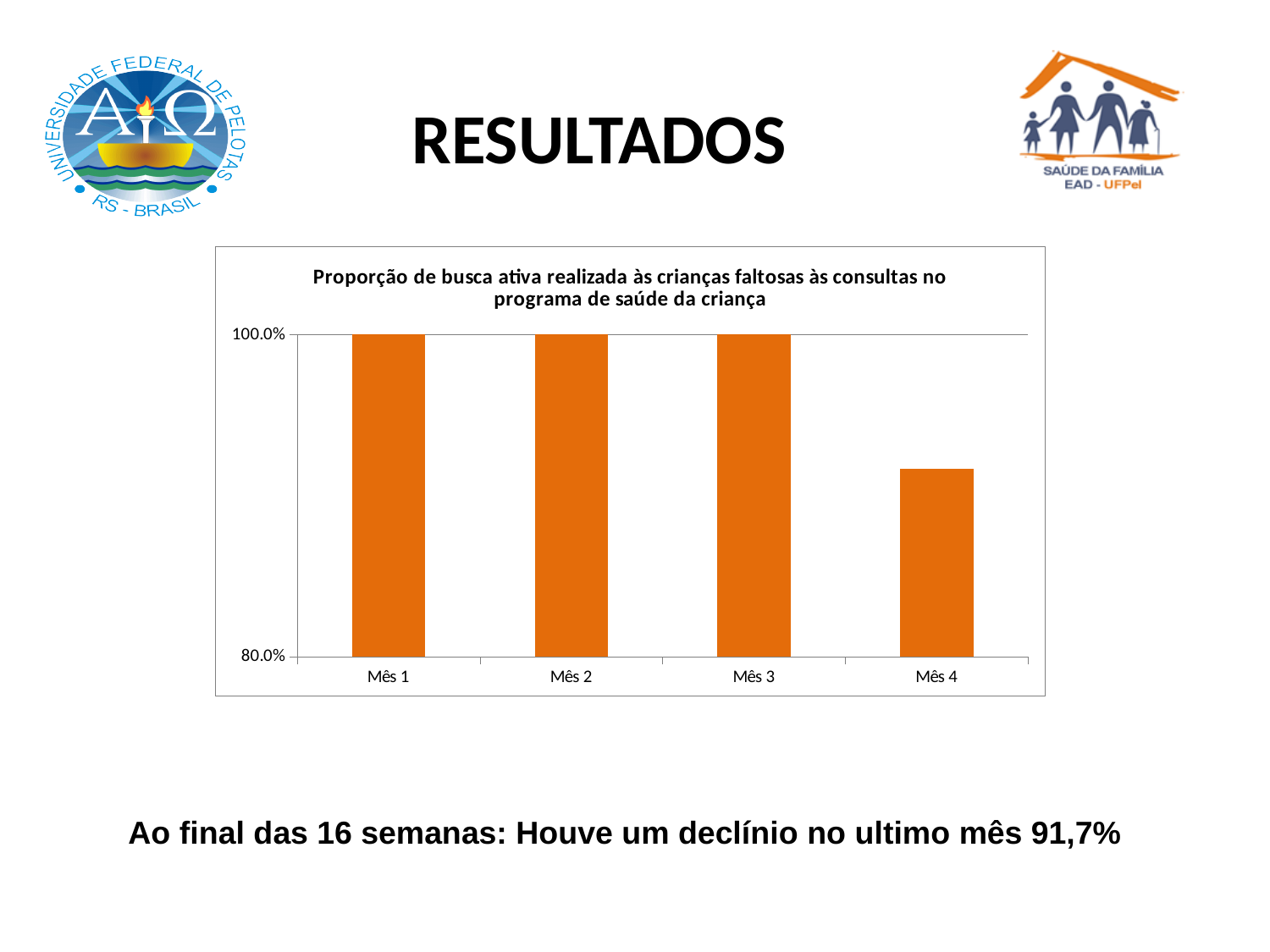
Is the value for Mês 4 greater or less than 80.0%? greater What colour are the bars in the chart? orange Do the values rise or fall from Mês 3 to Mês 4? fall Which month has the lowest value in the chart? Mês 4 Which is larger, the value for Mês 1 or the value for Mês 4? Mês 1 What is the title of the chart? Proporção de busca ativa realizada às crianças faltosas às consultas no programa de saúde da criança What is the value for Mês 3 in the chart? 100.0% What is the value for Mês 2 in the chart? 100.0% Is the value for Mês 4 greater or less than 100.0%? less What type of chart is shown on the slide? bar chart What is the value for Mês 1 in the chart? 100.0% How many months (categories) are shown on the x axis of the chart? 4